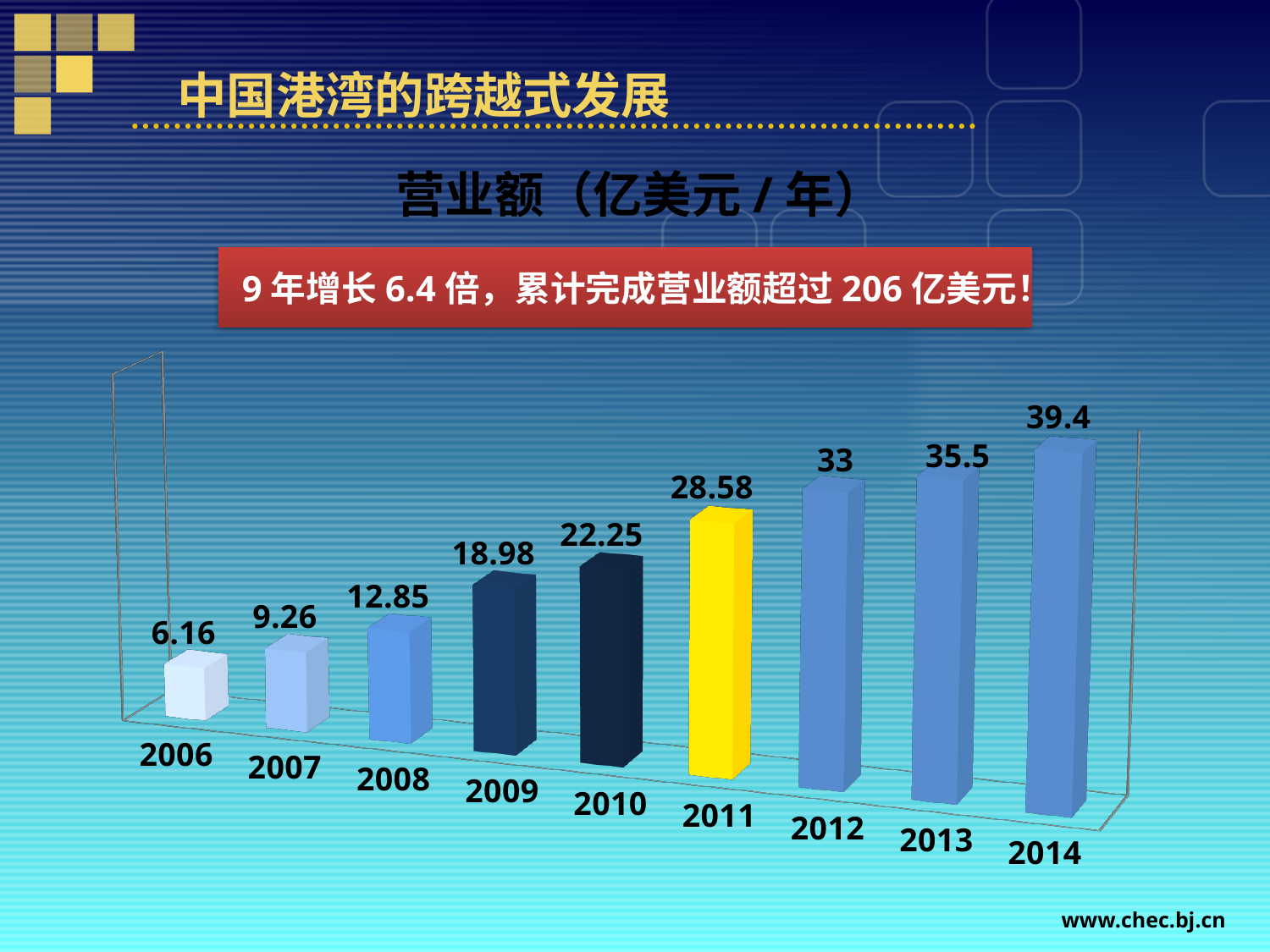
What kind of chart is shown on the slide? bar chart What is the value for 2011? 28.58 What is the difference between the values for 2014 and 2013? 3.9 What is the value for 2009? 18.98 How many years are shown on the chart? 9 Which is larger, the value for 2012 or the value for 2010? 2012 Which year has the lowest value? 2006 What is the difference between the values for 2010 and 2008? 9.4 Which year has the highest value? 2014 Do the values rise or fall from 2006 to 2014? rise What is the value for 2014? 39.4 What is the value for 2006? 6.16